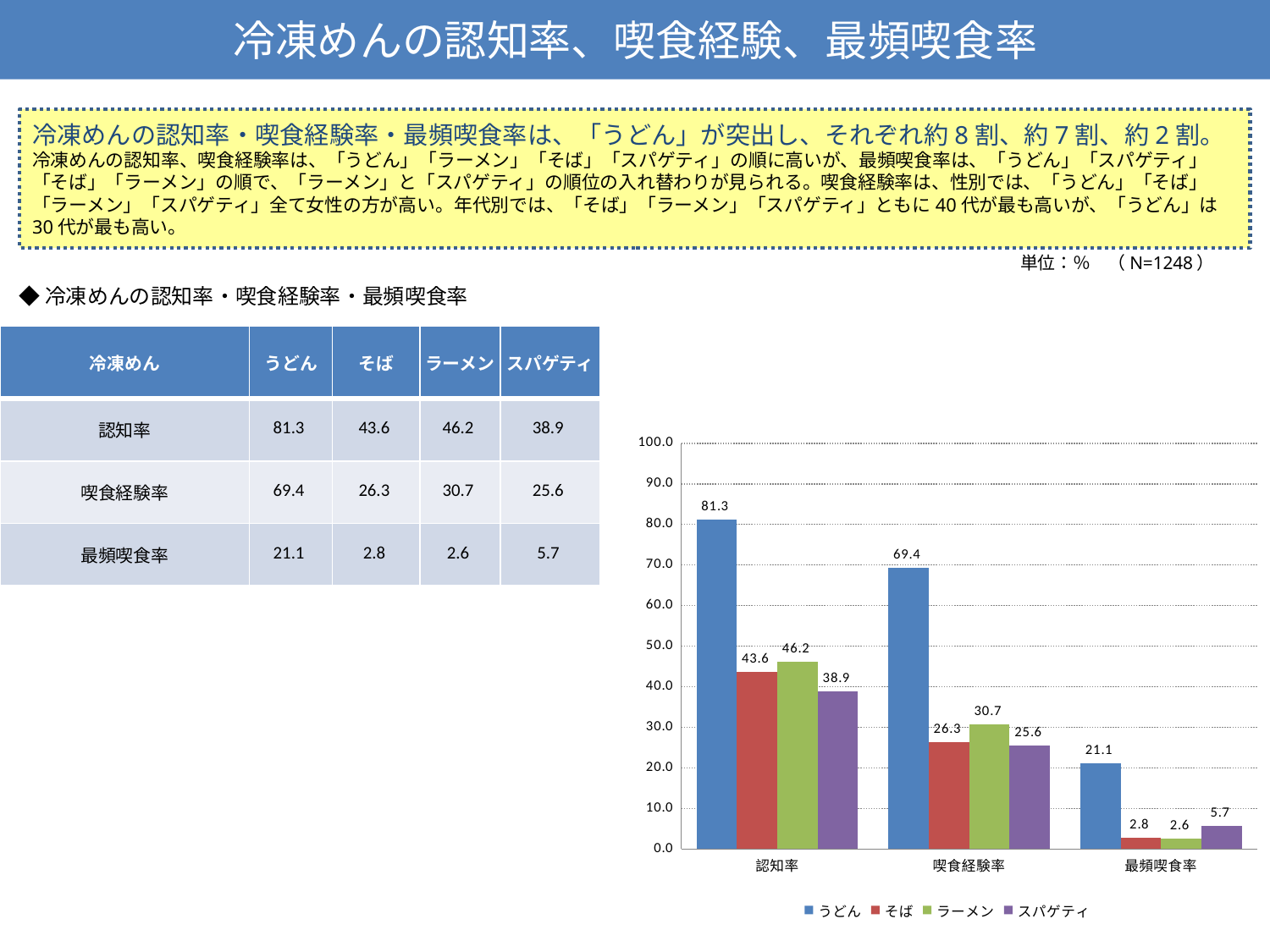
What is the value for うどん in the 認知率 category? 81.3 Which series is shown in the legend with a red colour? そば What is the difference between the うどん and そば values in the 喫食経験率 category? 43.1 What is the value for スパゲティ in the 最頻喫食率 category? 5.7 How many categories are shown on the x axis of the chart? 3 In the 認知率 category, which is larger: the value for ラーメン or the value for スパゲティ? ラーメン Which series has the highest value in the 認知率 category? うどん Which series has the lowest value in the 最頻喫食率 category? ラーメン Is the value for うどん in the 喫食経験率 category greater or less than 60.0? greater How many series does the chart legend list? 4 What type of chart is shown on the slide? bar chart What is the value for ラーメン in the 喫食経験率 category? 30.7